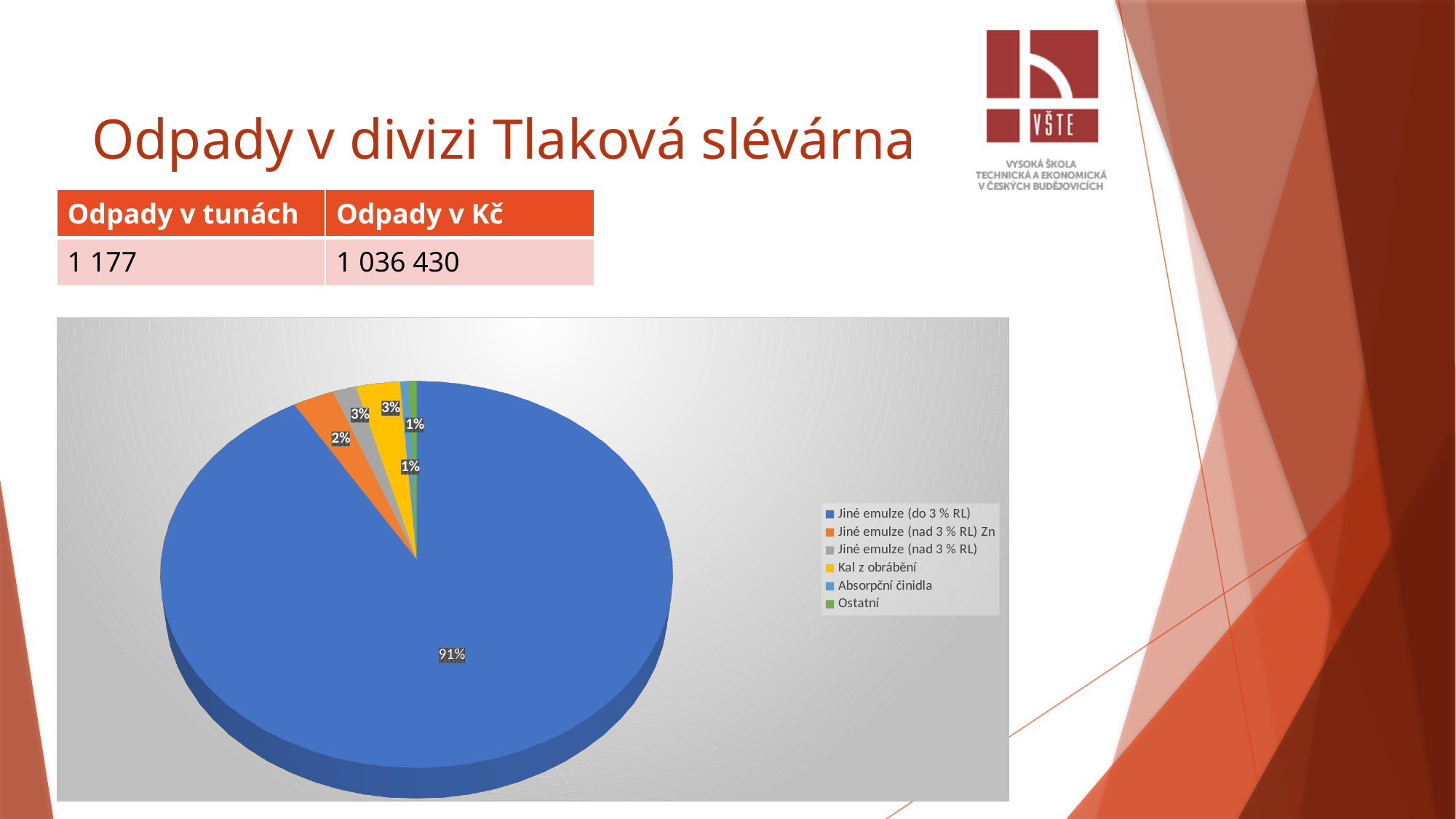
What is the value shown for Kal z obrábění? 3% What is the difference in percentage points between Jiné emulze (do 3 % RL) and Jiné emulze (nad 3 % RL) Zn? 89 percentage points Which is larger, the slice for Kal z obrábění or the slice for Jiné emulze (nad 3 % RL) Zn? Kal z obrábění What kind of chart is shown on the slide? pie chart How many slices does the pie chart have? 6 What is the value shown for Jiné emulze (nad 3 % RL) Zn? 2% Which category has the largest slice of the pie? Jiné emulze (do 3 % RL) What colour is the largest slice of the pie chart? blue What share of the pie does Jiné emulze (do 3 % RL) represent? 91% How many entries does the legend of the pie chart list? 6 Which legend entry is listed last in the pie chart's legend? Ostatní What is the value shown for Jiné emulze (nad 3 % RL)? 3%